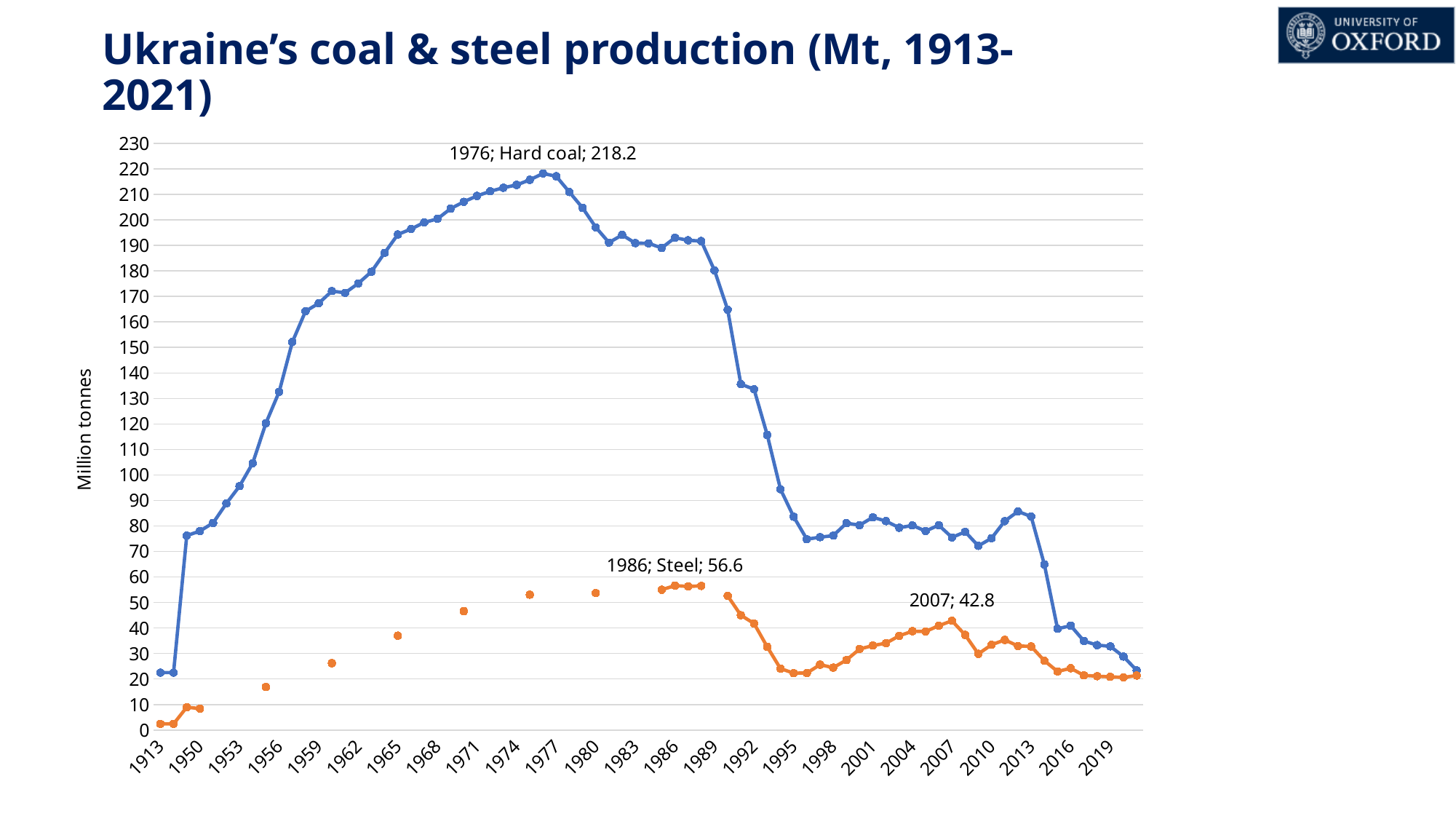
What is the label on the vertical axis? Million tonnes What is the difference between the labelled hard coal value in 1976 and the labelled steel value in 1986? 161.6 How much higher was the labelled steel value in 1986 than the labelled steel value in 2007? 13.8 What was Ukraine's steel production in 1986? 56.6 Is the hard coal value for 1913 greater or less than 30? less Does hard coal production rise or fall between 1950 and 1976? rise What kind of chart is shown on the slide? line chart What was Ukraine's steel production in 2007? 42.8 In which year did hard coal production reach its highest value? 1976 Which is larger: hard coal production in 1976 or steel production in 1986? hard coal production in 1976 Is the hard coal value for 1959 greater or less than 150? greater What was Ukraine's hard coal production in 1976? 218.2